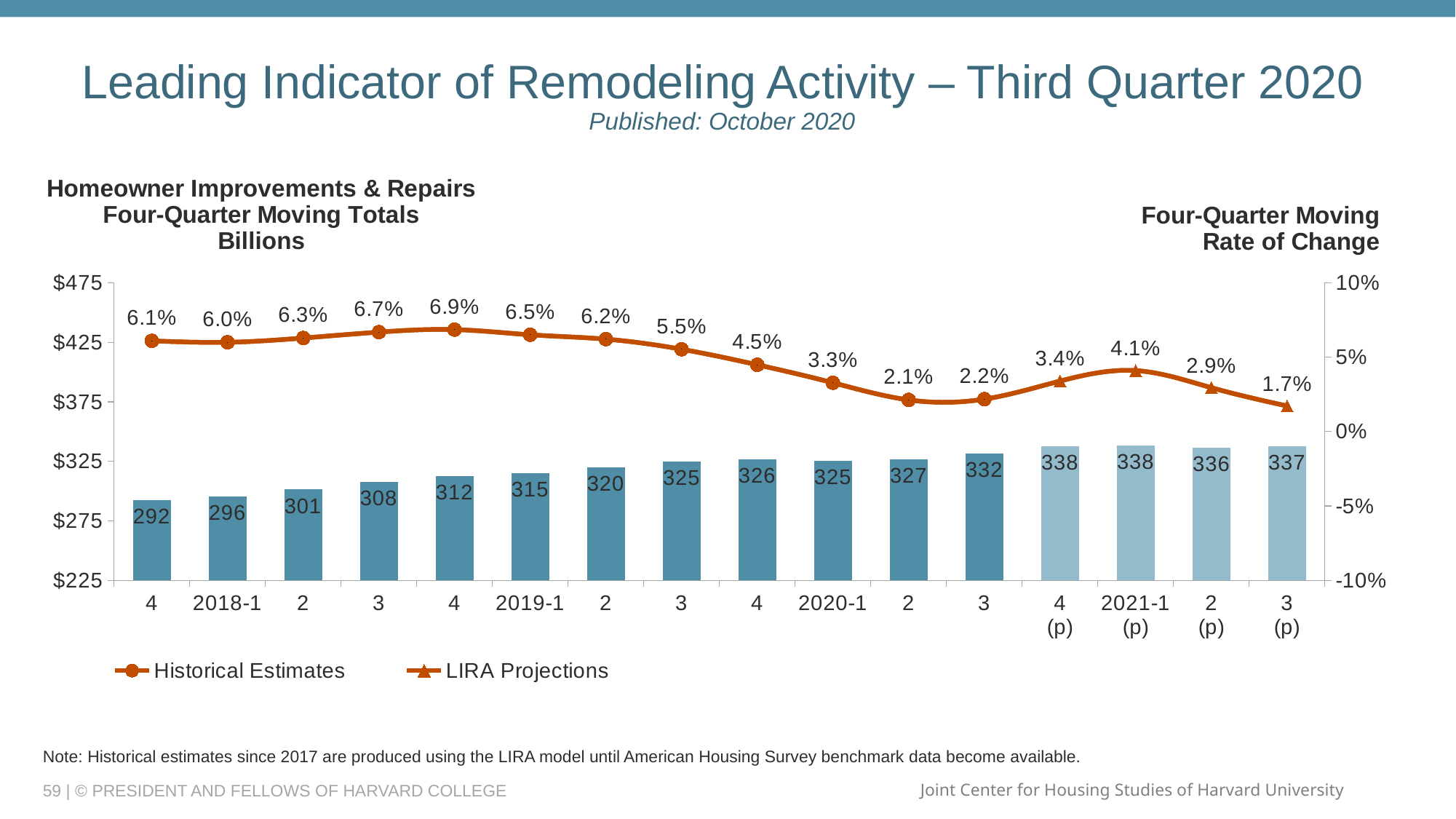
Which quarter has the lowest four-quarter moving rate of change? 2021-3 (p) (1.7%) By how many percentage points does the projected rate of change for 2021-1 (p) exceed that for 2021-2 (p)? 1.2 percentage points How many series does the legend list? 2 How many quarters (bars) are plotted on the chart? 16 What is the projected four-quarter moving total for 2021-2 (p)? 336 What is the lowest four-quarter moving total shown on the chart? 292 Which has the larger four-quarter moving total, 2019-2 or 2020-2? 2020-2 What is the projected rate of change for 2021-3 (p)? 1.7% Which quarter has the highest four-quarter moving rate of change? 2018-4 (6.9%) What is the four-quarter moving total (in billions) for 2020-3? 332 What is the difference between the four-quarter moving totals for 2020-3 and 2020-2? 5 What is the four-quarter moving rate of change for 2019-4? 4.5%